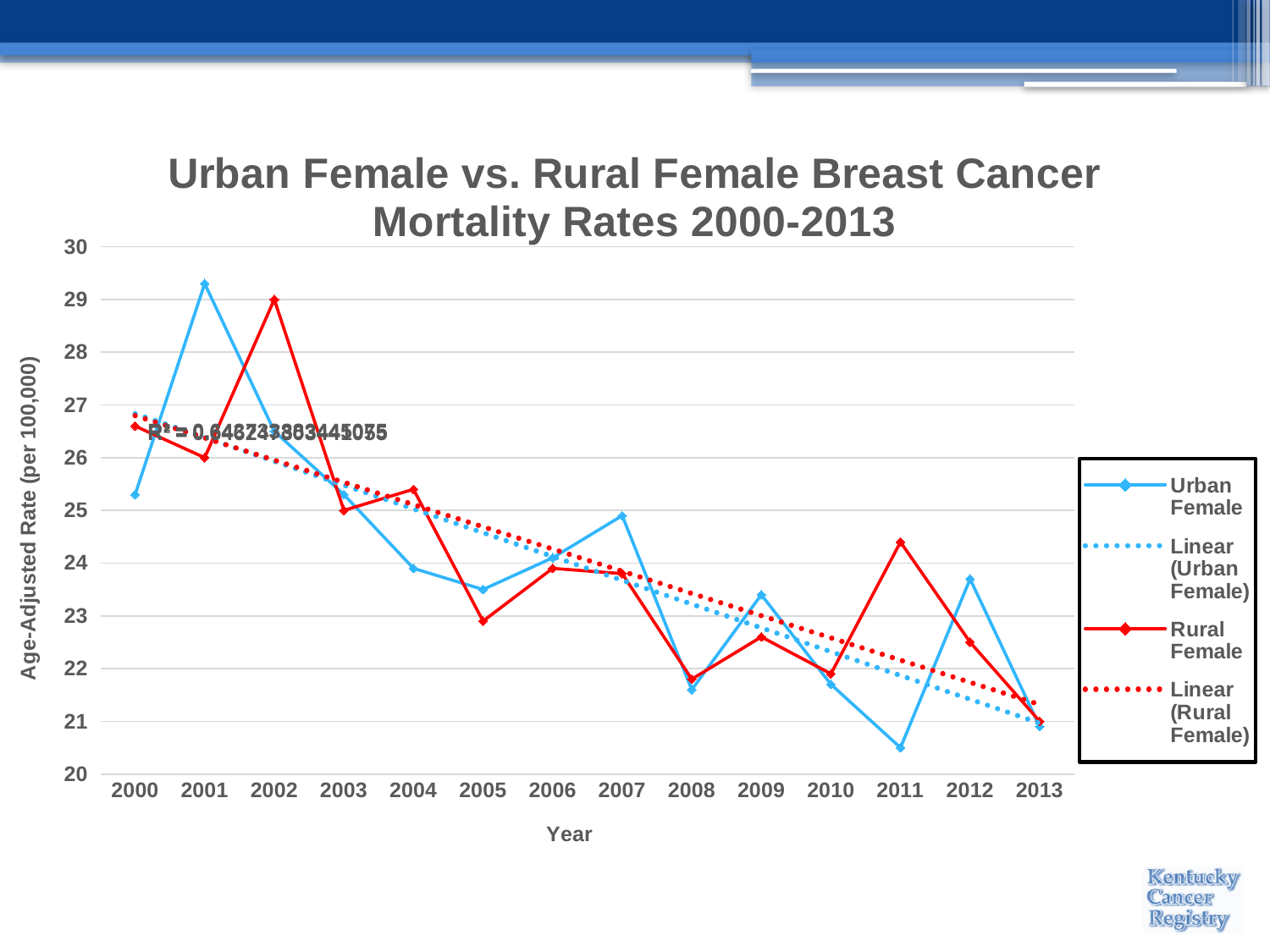
In which year is the Urban Female mortality rate lowest? 2011 How many entries does the legend list? 4 Is the Urban Female value for 2001 greater or less than 28? greater What kind of chart is shown on the slide? Line chart How many years are plotted along the x axis? 14 Is the Urban Female value for 2011 greater or less than 21? less In which year is the Rural Female mortality rate highest? 2002 What is the title of the y axis? Age-Adjusted Rate (per 100,000) Is the Rural Female value for 2002 greater or less than 28? greater In 2011, which series has the higher value, Urban Female or Rural Female? Rural Female In which year is the Urban Female mortality rate highest? 2001 Overall, do the mortality rates rise or fall from 2000 to 2013? Fall